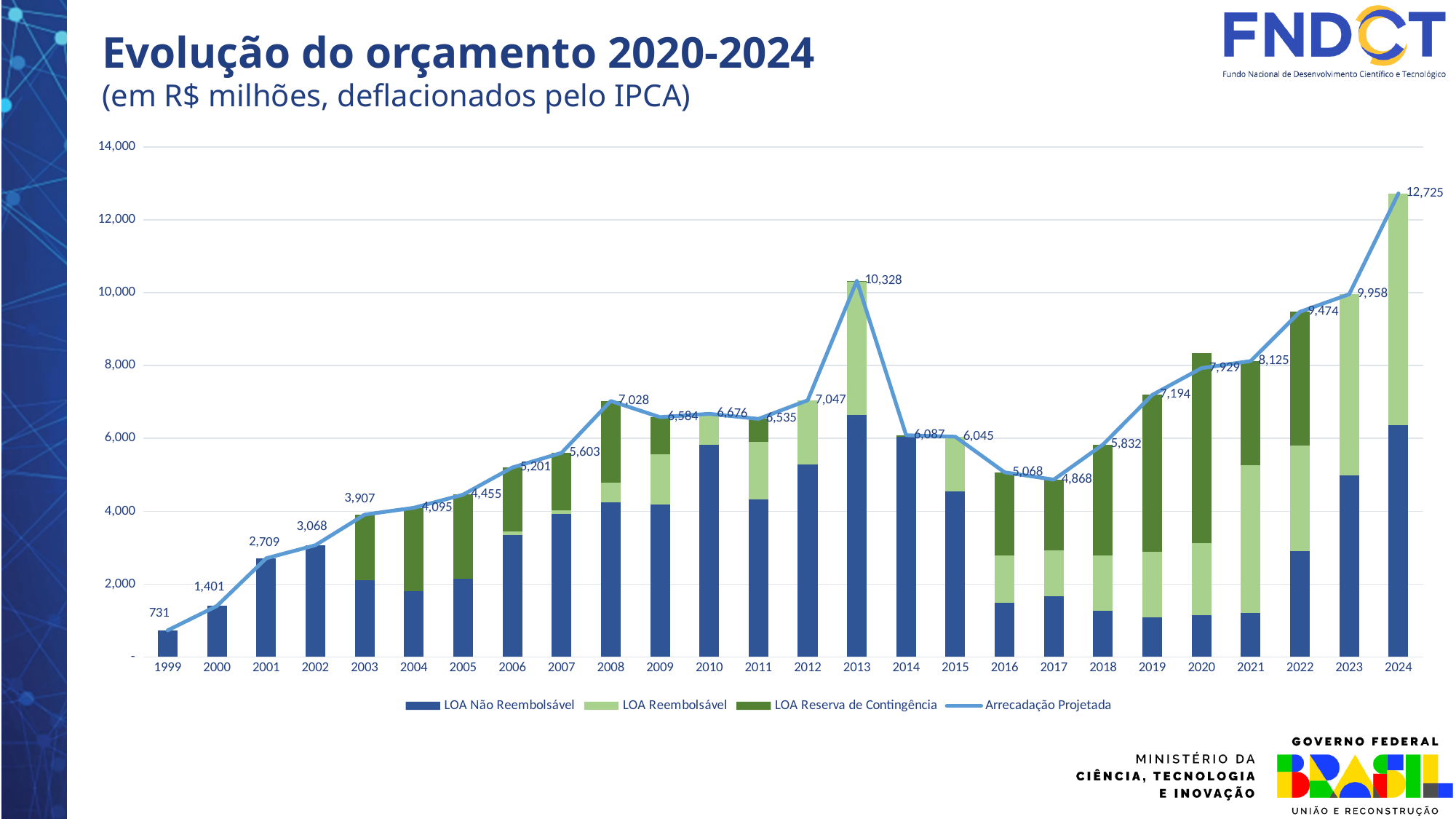
Which is larger, the Arrecadação Projetada value for 2008 or for 2012? 2012 What is the value of Arrecadação Projetada for 1999? 731 Is the total height of the stacked bar for 2020 greater or less than 8,000? greater What kind of chart is shown on the slide? Stacked bar chart with a line How many series does the legend list? 4 Which year has the lowest Arrecadação Projetada value? 1999 What is the value of Arrecadação Projetada for 2024? 12,725 Does the Arrecadação Projetada line rise or fall from 2017 to 2024? rise How many years are shown on the x axis? 26 What is the difference between the Arrecadação Projetada values for 2024 and 2023? 2,767 Which year has the highest Arrecadação Projetada value? 2024 What is the value of Arrecadação Projetada for 2013? 10,328